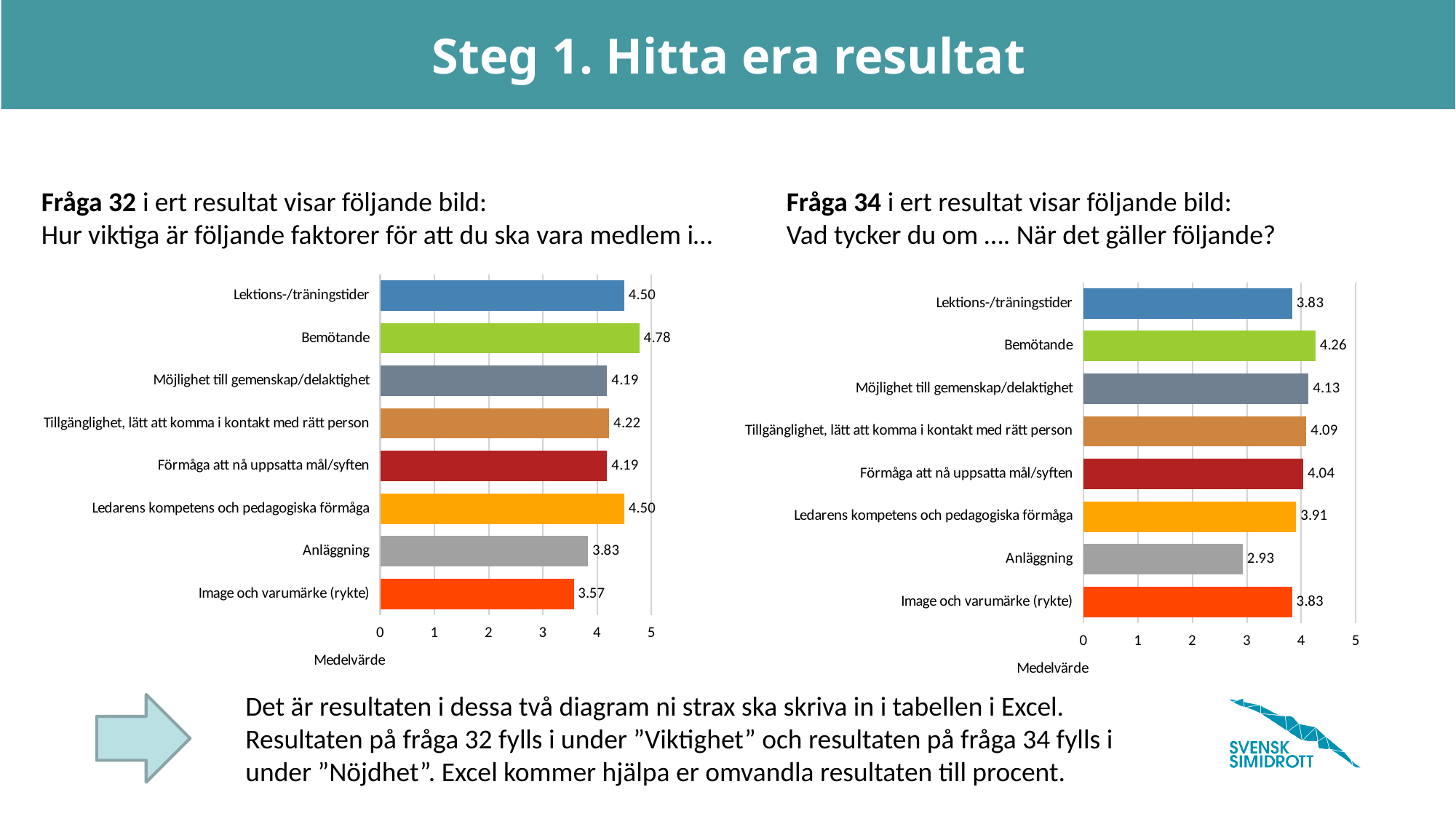
In the Fråga 34 chart on the right, which category has the highest value? Bemötande In the Fråga 32 chart on the left, what is the value for Bemötande? 4.78 In the Fråga 32 chart on the left, which is larger: the value for Tillgänglighet, lätt att komma i kontakt med rätt person or the value for Anläggning? Tillgänglighet, lätt att komma i kontakt med rätt person In the Fråga 34 chart on the right, what is the difference between the values for Bemötande and Anläggning? 1.33 In the Fråga 34 chart on the right, what is the value for Anläggning? 2.93 What kind of chart is the Fråga 34 chart on the right? Bar chart In the Fråga 34 chart on the right, which category has the lowest value? Anläggning In the Fråga 32 chart on the left, which category has the highest value? Bemötande In the Fråga 32 chart on the left, which category has the lowest value? Image och varumärke (rykte) What is the x-axis label of the Fråga 32 chart on the left? Medelvärde In the Fråga 34 chart on the right, is the value for Anläggning greater or less than 3? less How many categories are shown in the Fråga 32 chart on the left? 8